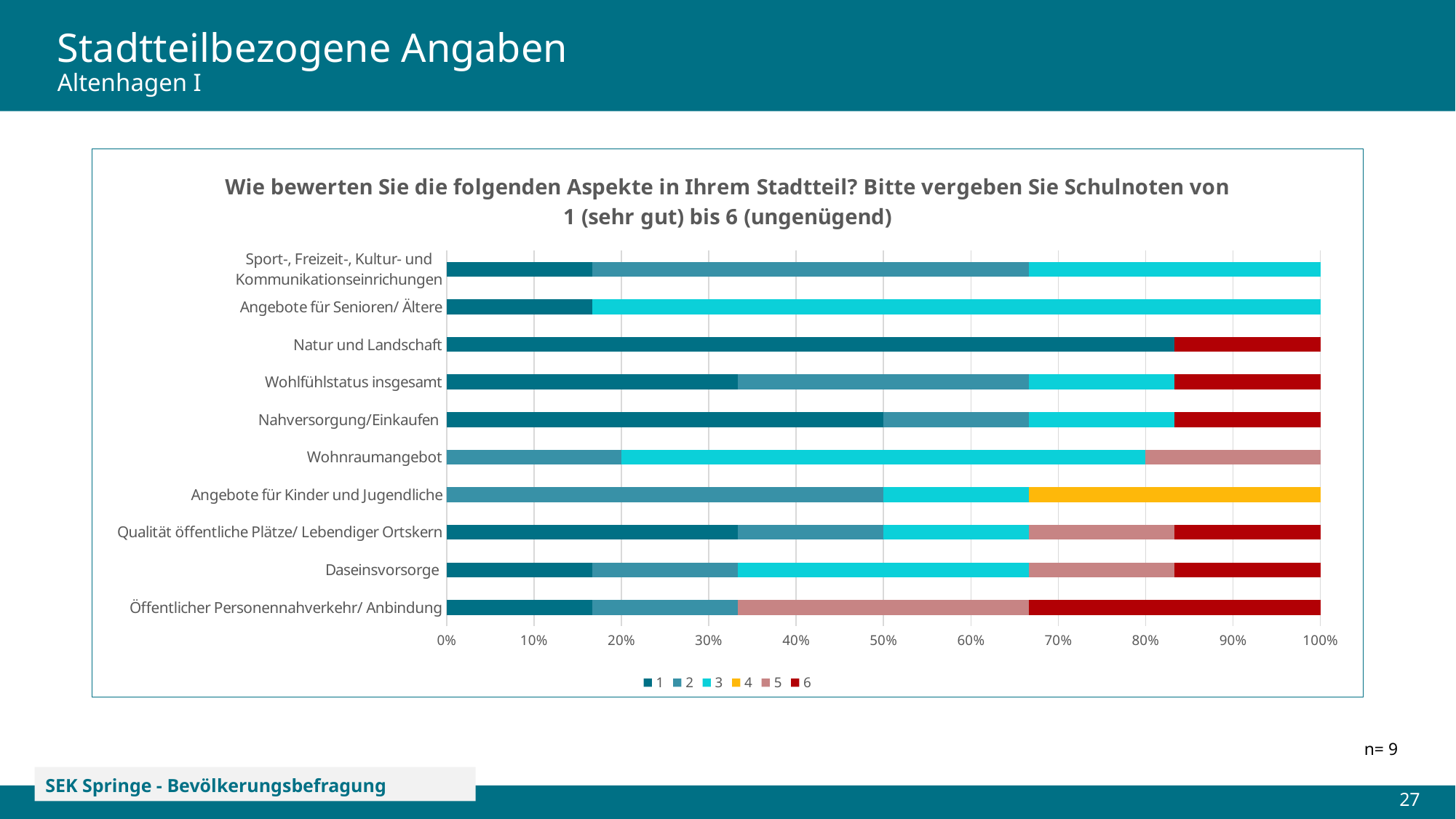
Which category has the largest share of grade 6? Öffentlicher Personennahverkehr/ Anbindung Is the share of grade 3 for Angebote für Senioren/ Ältere greater or less than 70%? greater Is the share of grade 2 for Wohnraumangebot greater or less than 30%? less What kind of chart is shown on the slide? Stacked bar chart Which category has the largest share of grade 1? Natur und Landschaft How many series does the legend of the chart list? 6 What is the sample size (n) stated on the slide? n= 9 Is the share of grade 1 for Natur und Landschaft greater or less than 80%? greater Which has the larger share of grade 1: Nahversorgung/Einkaufen or Wohlfühlstatus insgesamt? Nahversorgung/Einkaufen How many categories (aspects) are listed on the vertical axis of the chart? 10 Which is the only category that contains a grade 4 segment? Angebote für Kinder und Jugendliche